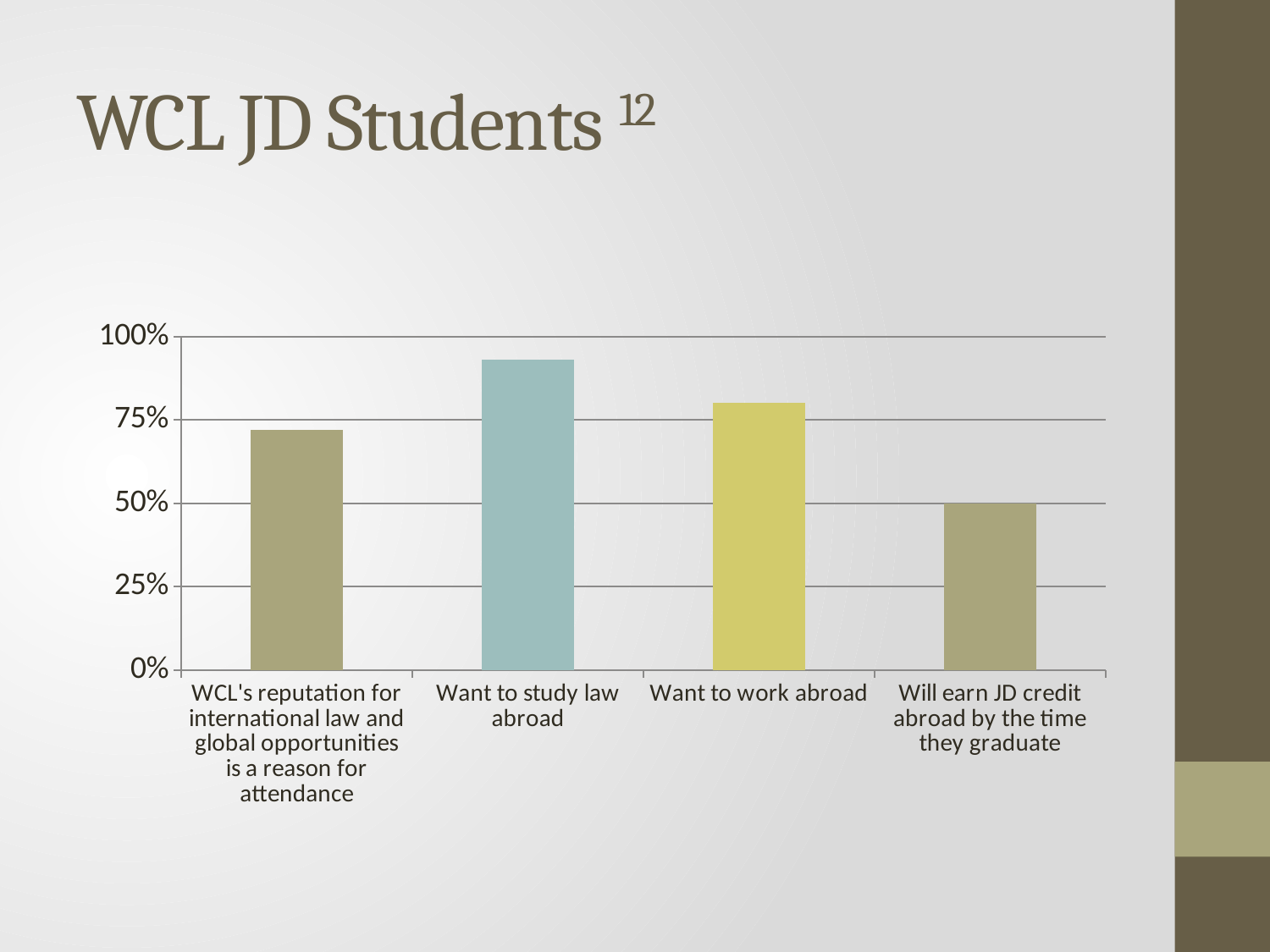
What kind of chart is shown on the slide? bar chart Which is larger: the value for "Want to work abroad" or the value for "WCL's reputation for international law and global opportunities is a reason for attendance"? Want to work abroad Is the value for "Want to work abroad" greater or less than 75%? greater Which category has the lowest value? Will earn JD credit abroad by the time they graduate Which category has the highest value? Want to study law abroad Is the value for "WCL's reputation for international law and global opportunities is a reason for attendance" greater or less than 50%? greater How many categories are plotted in the chart? 4 Is the value for "WCL's reputation for international law and global opportunities is a reason for attendance" greater or less than 75%? less Which is larger: the value for "Want to study law abroad" or the value for "Want to work abroad"? Want to study law abroad What is the value for "Will earn JD credit abroad by the time they graduate"? 50% What is the title of the slide containing the chart? WCL JD Students